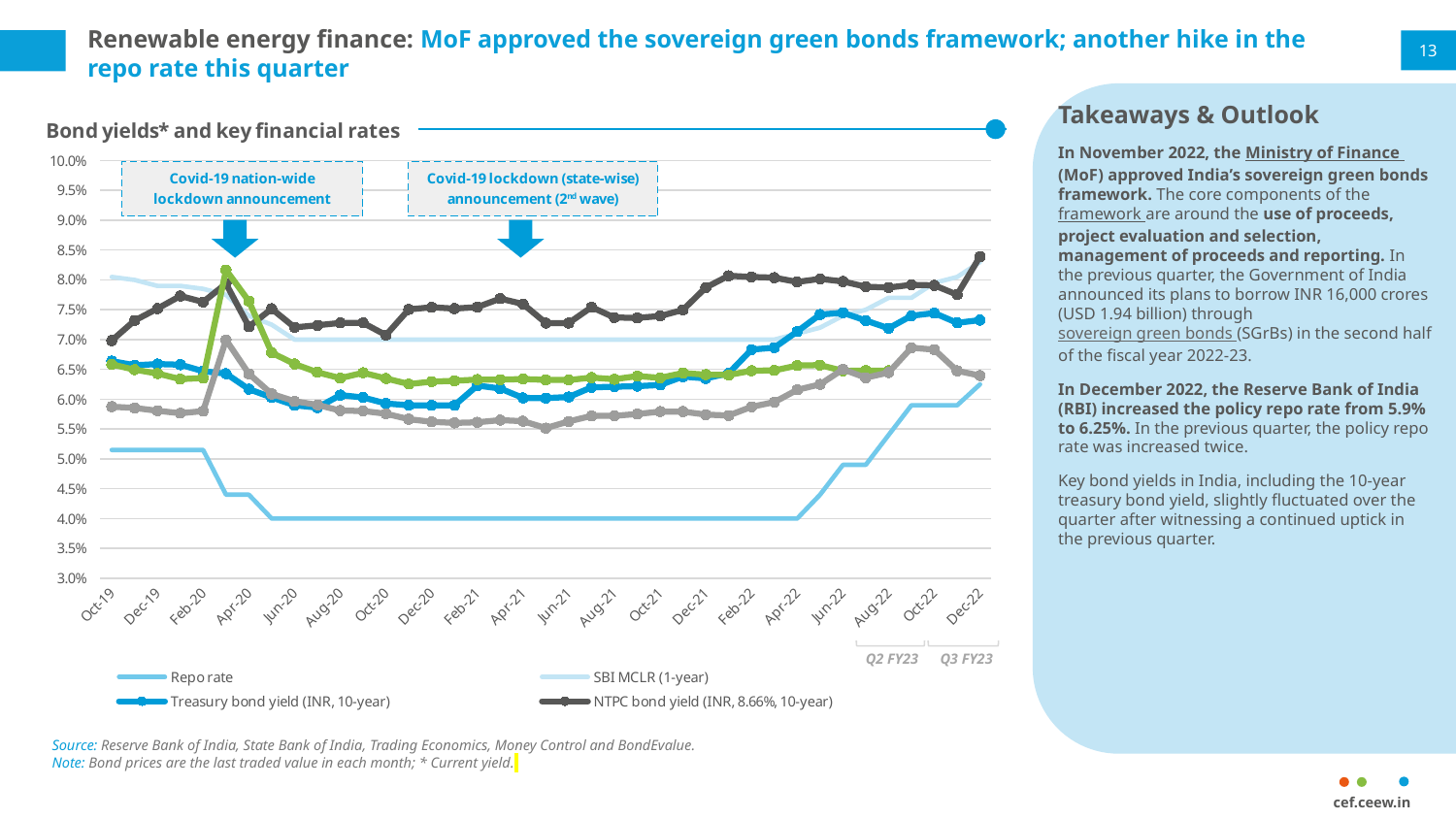
How many series does the legend of the chart list? 4 Which series is the lowest in Apr-21? Repo rate Is the NTPC bond yield (INR, 8.66%, 10-year) in Dec-22 greater or less than 8.0%? greater Does the repo rate rise or fall from Apr-22 to Dec-22? Rise What type of chart is 'Bond yields* and key financial rates'? Line chart How many month labels are shown on the x axis of the chart? 20 Is the Treasury bond yield (INR, 10-year) in Jun-22 greater or less than 7.0%? greater What is the highest value shown on the y axis of the chart? 10.0% Is the repo rate in Apr-21 greater or less than 4.5%? less What is the repo rate in Jun-20 according to the chart? 4.0% In Dec-20, which is larger: the repo rate or the Treasury bond yield (INR, 10-year)? Treasury bond yield (INR, 10-year) Which series is the highest in Oct-19? SBI MCLR (1-year)